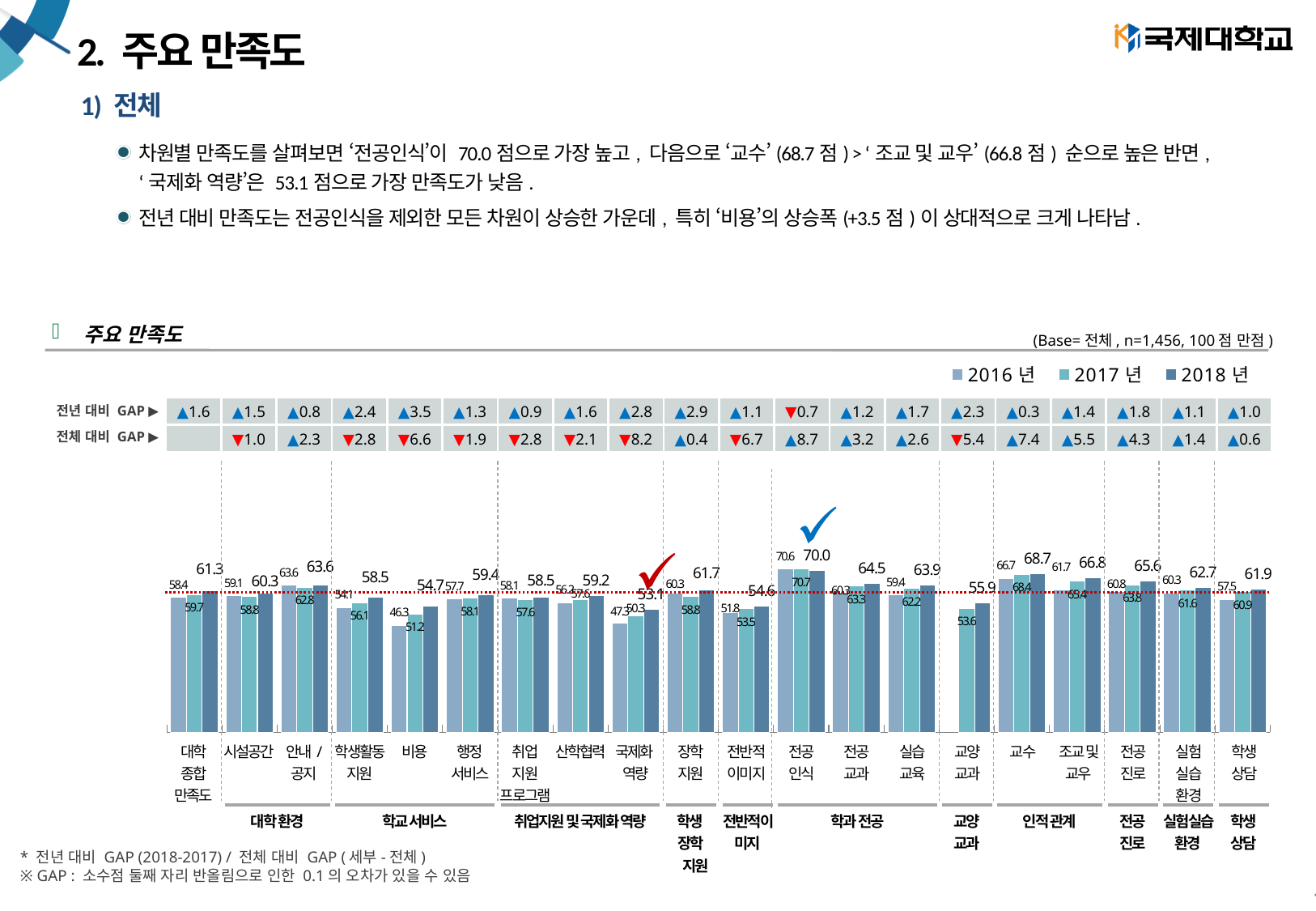
Do the values for 비용 rise or fall from 2016년 to 2018년? Rise What is the difference between the 2018년 values for 교수 and 조교 및 교우? 1.9 Which category has the highest 2018년 value? 전공 인식 What is the 2018년 value for 전공 인식? 70.0 What kind of chart is shown on the slide? Bar chart How many series does the legend list? 3 Which is larger, the 2018년 value for 전공 교과 or for 실습 교육? 전공 교과 By how much did the value for 비용 increase from 2017년 to 2018년? 3.5 What is the 2017년 value for 비용? 51.2 What is the 2018년 value for 국제화 역량? 53.1 Which category has the lowest 2018년 value? 국제화 역량 How many categories are shown along the x axis of the chart? 20